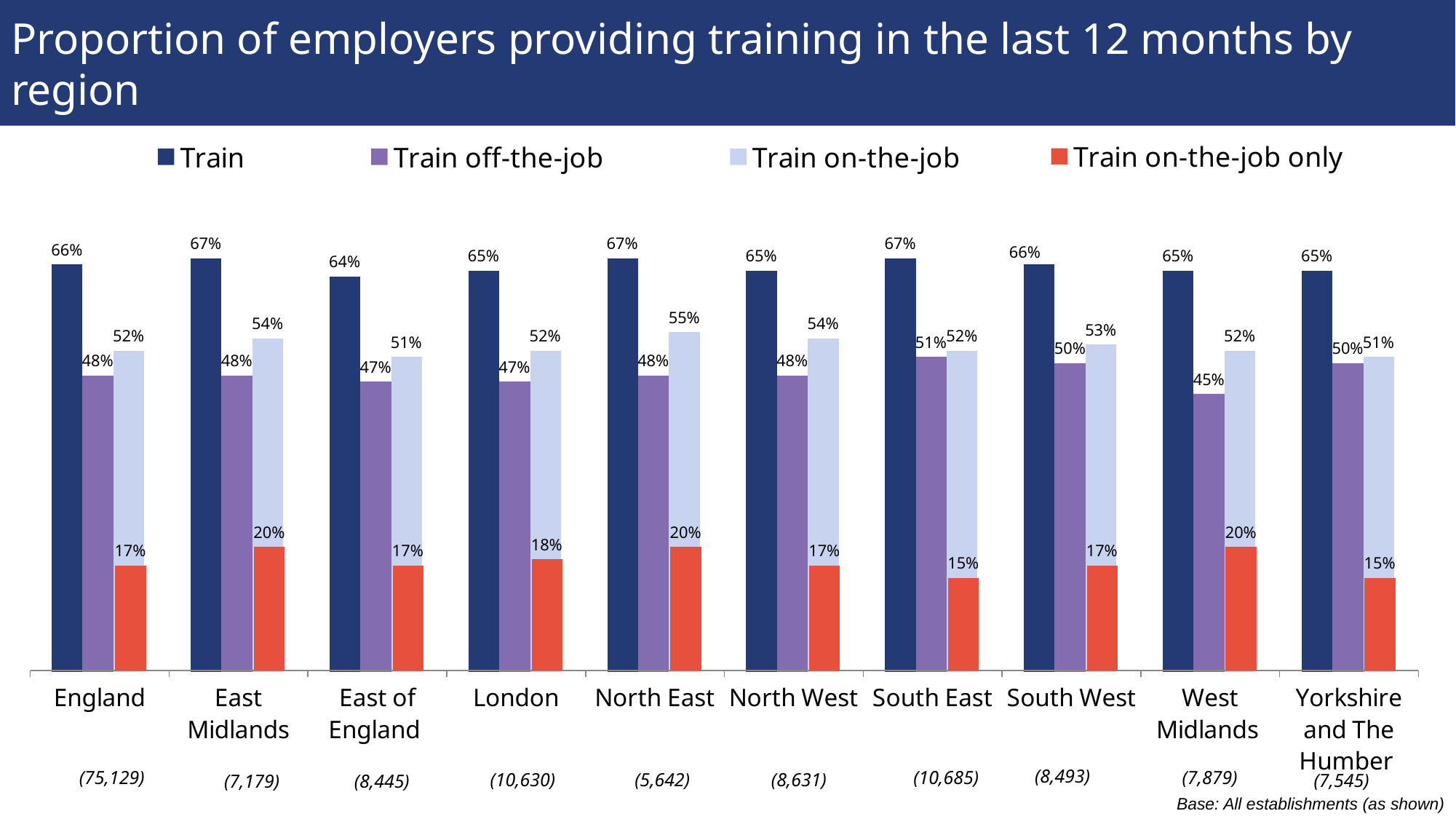
What kind of chart is shown on the slide? Bar chart What is the difference between Train on-the-job and Train on-the-job only in England? 35 percentage points Which region has the lowest value for Train? East of England How many series does the legend list? 4 Which region has the highest value for Train on-the-job? North East What is the value for Train on-the-job in South West? 53% What is the value for Train off-the-job in West Midlands? 45% How many regions are shown on the x axis? 10 What is the value for Train on-the-job only in London? 18% Which region has the highest value for Train off-the-job? South East Which is larger: Train off-the-job in West Midlands or Train off-the-job in Yorkshire and The Humber? Yorkshire and The Humber What is the value for Train in East Midlands? 67%